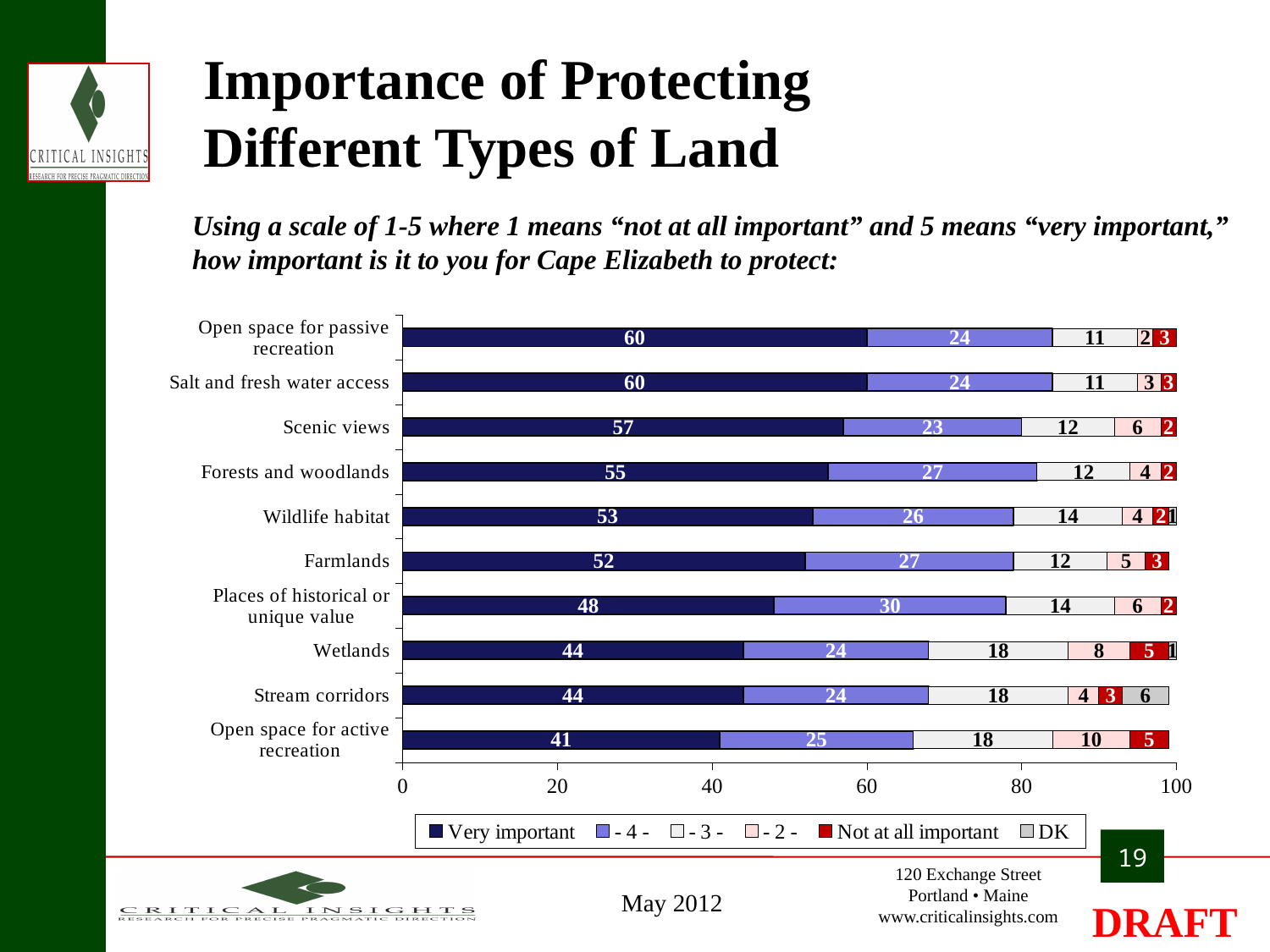
What kind of chart is shown on the slide? Stacked bar chart What is the "Very important" value for Forests and woodlands? 55 What is the "- 4 -" value for Places of historical or unique value? 30 Which land type has the highest "- 4 -" value? Places of historical or unique value Which land type has the lowest "Very important" value? Open space for active recreation What is the difference between the "Very important" values for Scenic views and Farmlands? 5 What is the total of the labelled segments in the Scenic views bar? 100 What is the DK value for Stream corridors? 6 Which has a larger "Very important" value, Forests and woodlands or Wildlife habitat? Forests and woodlands How many series does the legend list? 6 How many land types (categories) are plotted in the chart? 10 Which land type has the highest "- 2 -" value? Open space for active recreation